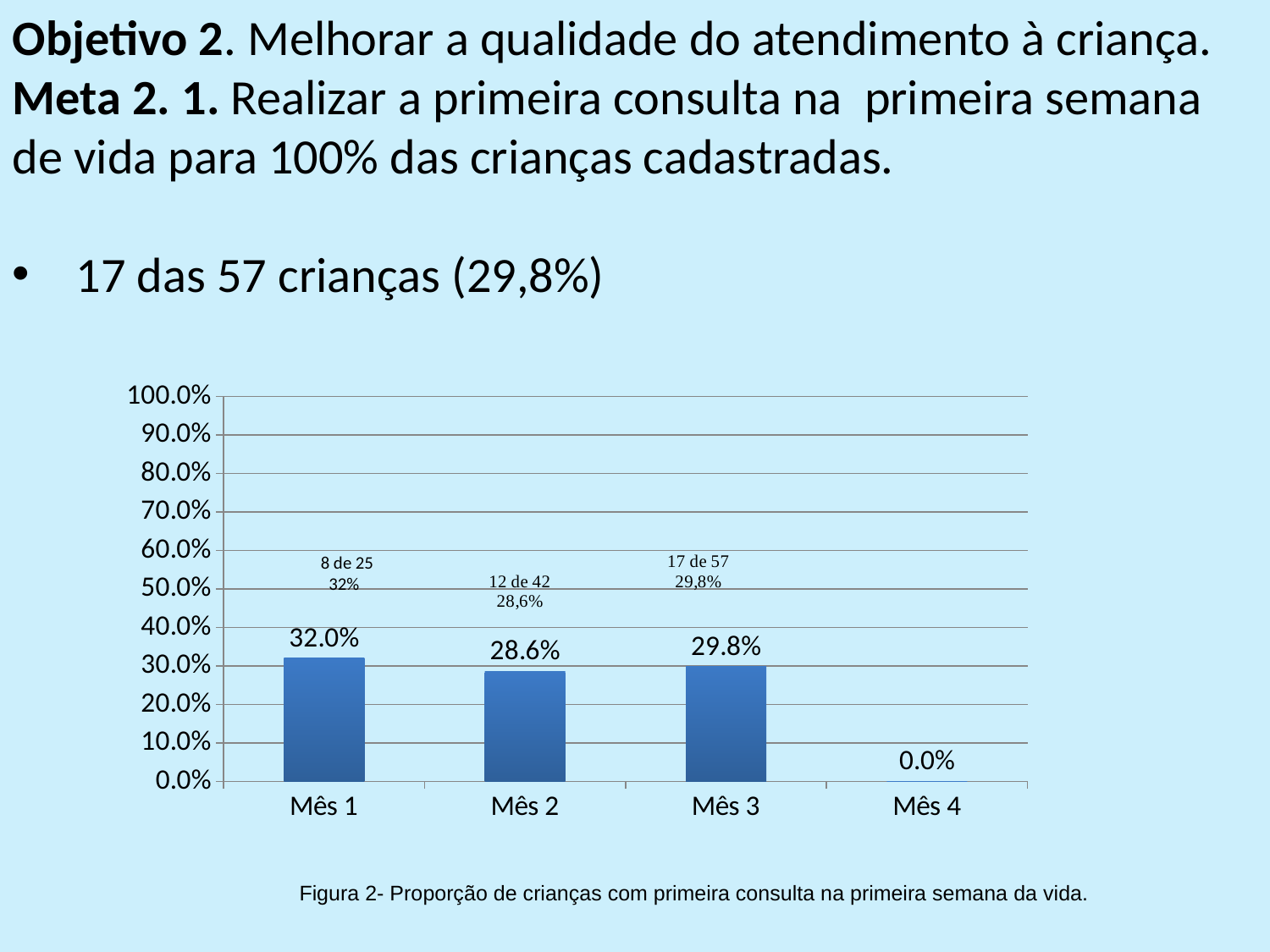
What is the value for Mês 3? 29.8% Is the value for Mês 1 greater or less than 40.0%? less What is the value for Mês 1? 32.0% What is the difference between the values for Mês 1 and Mês 2? 3.4% What is the caption of the figure below the chart? Figura 2- Proporção de crianças com primeira consulta na primeira semana da vida. What is the value for Mês 4? 0.0% What kind of chart is shown on the slide? bar chart What is the value for Mês 2? 28.6% Which is larger, the value for Mês 3 or the value for Mês 2? Mês 3 How many months are shown on the x axis? 4 Which month has the lowest value? Mês 4 Which month has the highest value? Mês 1